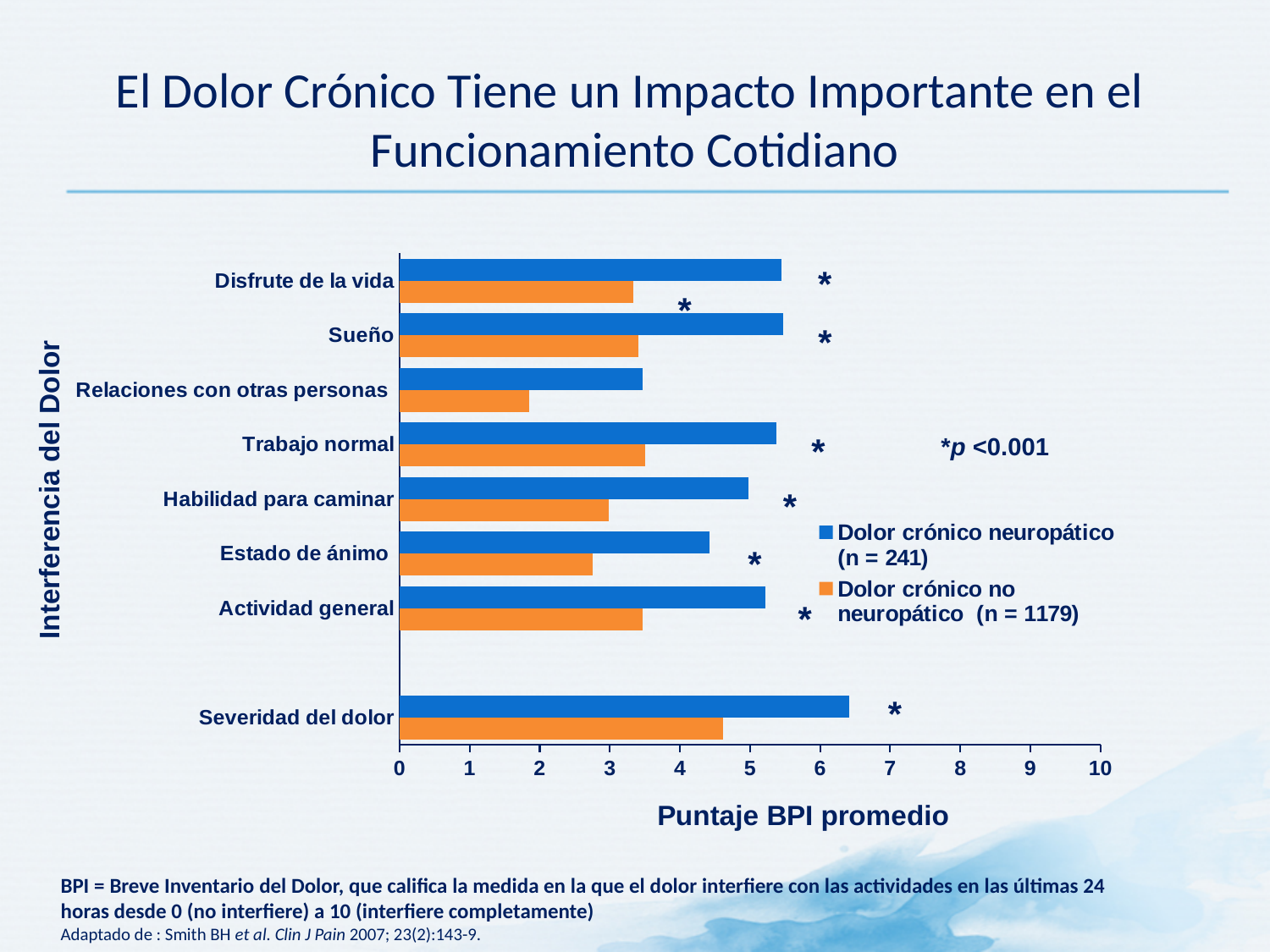
Is the Dolor crónico neuropático value for Estado de ánimo greater or less than 5? less Is the Dolor crónico neuropático value for Severidad del dolor greater or less than 6? greater Is the Dolor crónico no neuropático value for Relaciones con otras personas greater or less than 2? less How many series does the legend list? 2 Which category has the lowest value for the Dolor crónico no neuropático series? Relaciones con otras personas What kind of chart is shown on the slide? bar chart Which category has the lowest value for the Dolor crónico neuropático series? Relaciones con otras personas For Sueño, which series has the larger value: Dolor crónico neuropático or Dolor crónico no neuropático? Dolor crónico neuropático What is the sample size shown in the legend for the Dolor crónico no neuropático series? n = 1179 Which category has the highest value for the Dolor crónico neuropático series? Severidad del dolor What is the title of the x axis? Puntaje BPI promedio How many categories are plotted on the y axis? 8